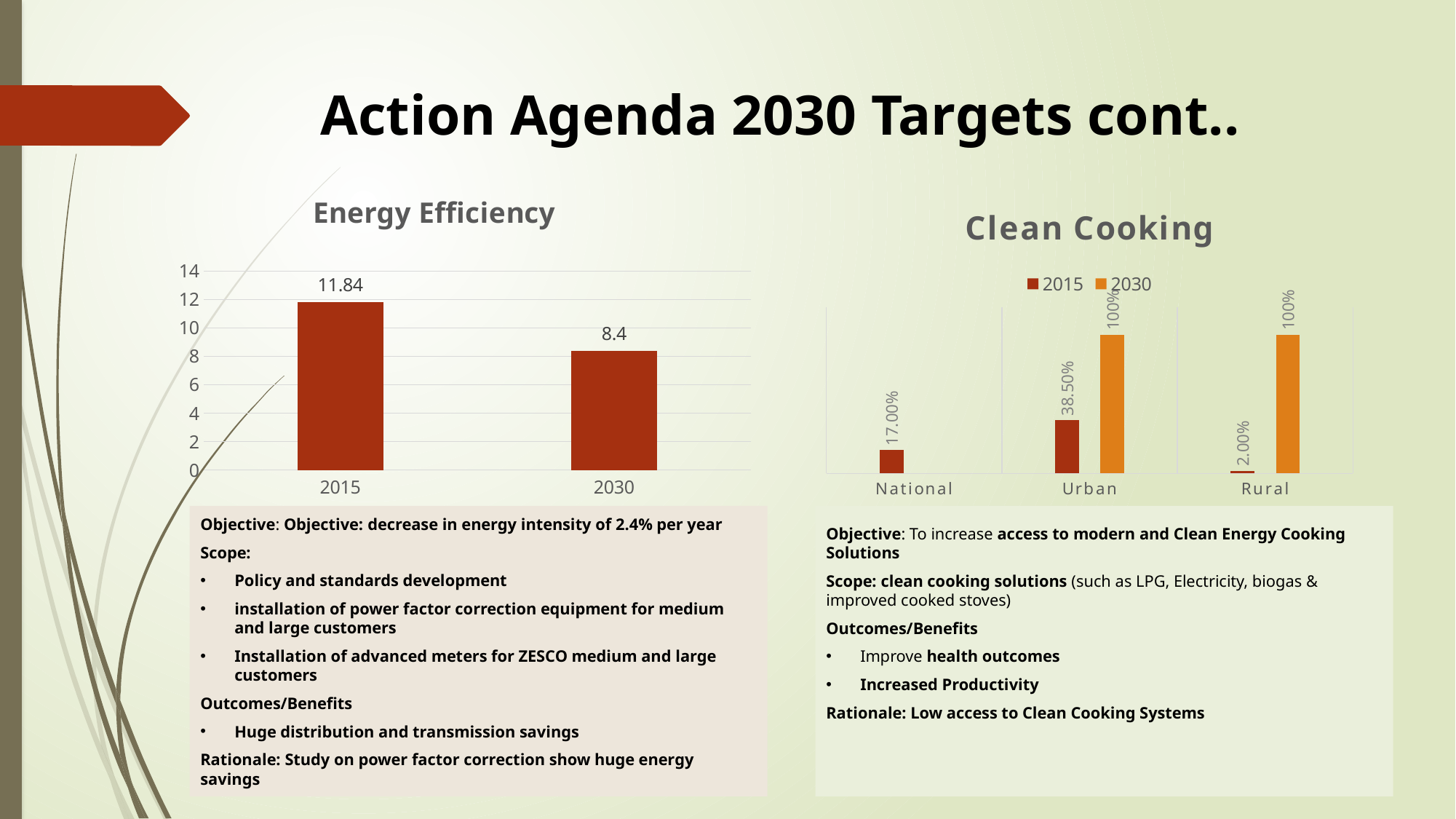
In the Clean Cooking chart, what is the difference between the Urban 2030 value and the Urban 2015 value? 61.50% In the Clean Cooking chart, what is the 2015 value for Urban? 38.50% In the Energy Efficiency chart, do the values rise or fall from 2015 to 2030? fall In the Clean Cooking chart, what is the 2015 value for National? 17.00% In the Clean Cooking chart, which category has the lowest 2015 value? Rural In the Clean Cooking chart, what is the 2015 value for Rural? 2.00% In the Energy Efficiency chart, what is the difference between the 2015 and 2030 values? 3.44 In the Clean Cooking chart, how many series does the legend list? 2 In the Energy Efficiency chart, what is the value for 2030? 8.4 In the Energy Efficiency chart, what is the value for 2015? 11.84 In the Energy Efficiency chart, how many categories are shown on the x axis? 2 What kind of chart is the Energy Efficiency chart? bar chart